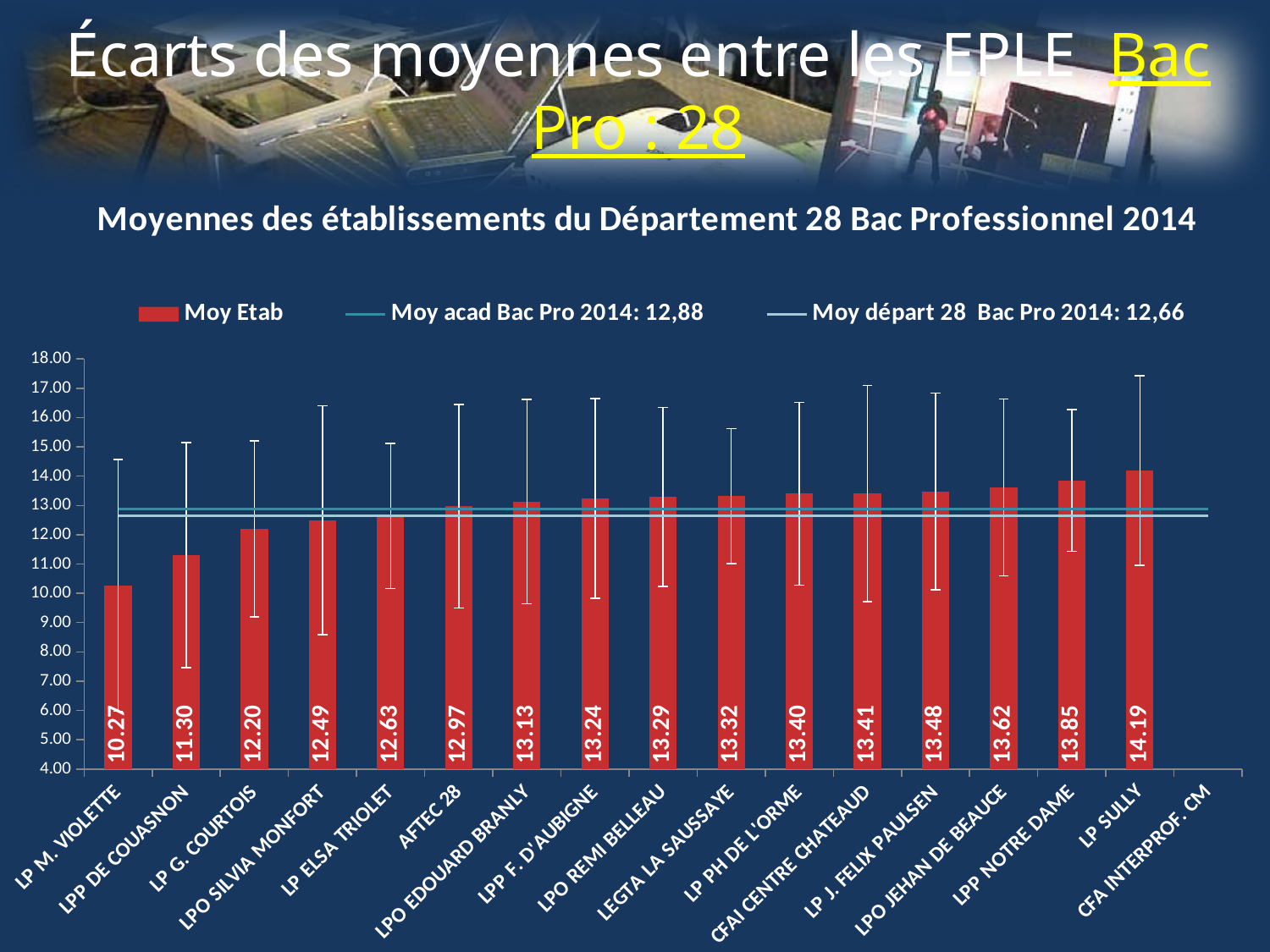
Which establishment has the highest average? LP SULLY Which establishment has the lowest average? LP M. VIOLETTE What is the value for LPP NOTRE DAME? 13.85 What is the difference between the values for LP SULLY and LP M. VIOLETTE? 3.92 How many series does the legend list? 3 What is the value for LP SULLY? 14.19 What is the value for LPO SILVIA MONFORT? 12.49 Which is larger, the value for LPP DE COUASNON or LP G. COURTOIS? LP G. COURTOIS Do the bar values rise or fall from left to right along the x axis? rise What is the difference between the values for LPP NOTRE DAME and LPO JEHAN DE BEAUCE? 0.23 According to the legend, what is the value of 'Moy acad Bac Pro 2014'? 12,88 What kind of chart is this? bar chart